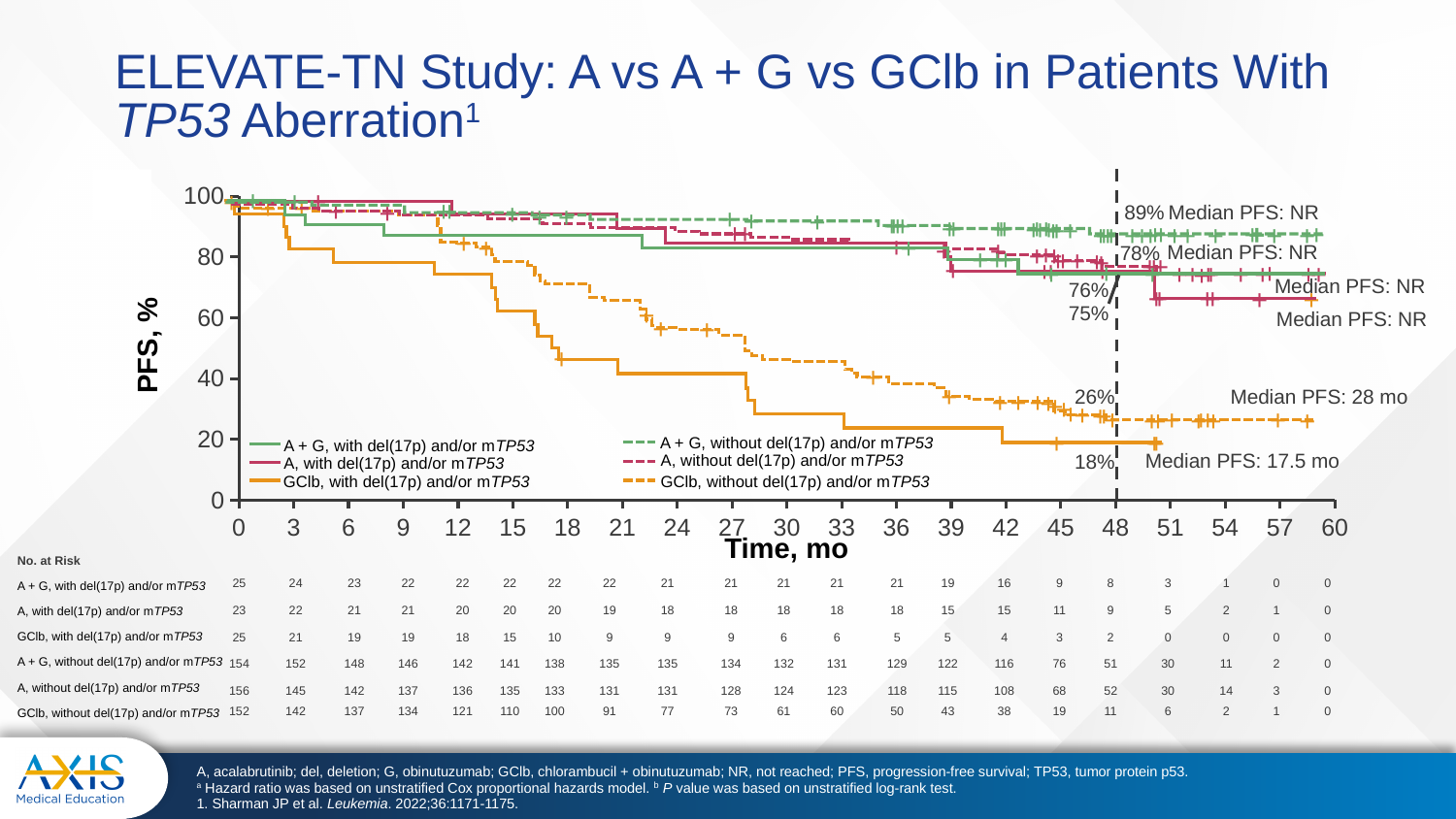
Which series has the highest PFS rate at 48 months? A + G, without del(17p) and/or mTP53 What is the PFS rate at 48 months for A + G, without del(17p) and/or mTP53? 89% What is the difference between the 48-month PFS rates of A + G, without del(17p) and/or mTP53 (89%) and GClb, without del(17p) and/or mTP53 (26%)? 63% Is the PFS for GClb, with del(17p) and/or mTP53 at 30 months greater or less than 40%? less Which series has the lowest PFS rate at 48 months? GClb, with del(17p) and/or mTP53 What is the median PFS for GClb, with del(17p) and/or mTP53? 17.5 mo What is the PFS rate at 48 months for GClb, with del(17p) and/or mTP53? 18% How many series does the legend list? 6 What is the label of the y axis? PFS, % What kind of chart is shown on the slide? Line chart (Kaplan-Meier curve) What is the median PFS for GClb, without del(17p) and/or mTP53? 28 mo What is the median PFS for A, with del(17p) and/or mTP53? NR